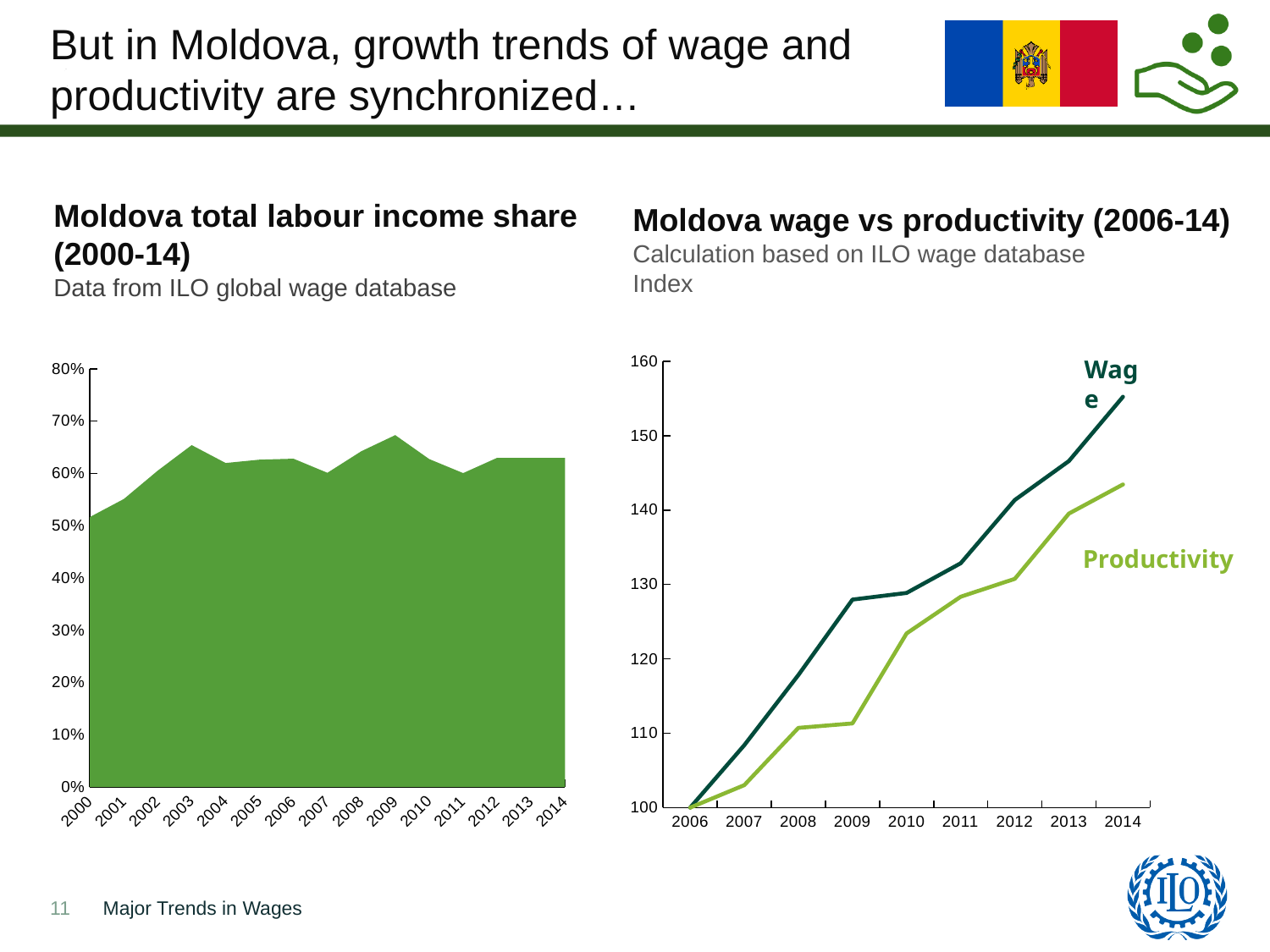
In the 'Moldova wage vs productivity (2006-14)' chart, how many years are shown on the x axis? 9 In the 'Moldova wage vs productivity (2006-14)' chart, do the Wage values rise or fall from 2006 to 2014? rise In the 'Moldova wage vs productivity (2006-14)' chart, which series is higher in 2012, Wage or Productivity? Wage What kind of chart is the 'Moldova total labour income share (2000-14)' chart? area chart In the 'Moldova wage vs productivity (2006-14)' chart, is the Wage value for 2014 greater or less than 150? greater In the 'Moldova total labour income share (2000-14)' chart, how many years are shown on the x axis? 15 In the 'Moldova wage vs productivity (2006-14)' chart, is the Productivity value for 2014 greater or less than 140? greater In the 'Moldova wage vs productivity (2006-14)' chart, what are the names of the two series? Wage and Productivity In the 'Moldova total labour income share (2000-14)' chart, is the value for 2000 greater or less than 50%? greater What kind of chart is the 'Moldova wage vs productivity (2006-14)' chart? line chart In the 'Moldova total labour income share (2000-14)' chart, which year has the lowest labour income share? 2000 In the 'Moldova wage vs productivity (2006-14)' chart, how many series are plotted? 2